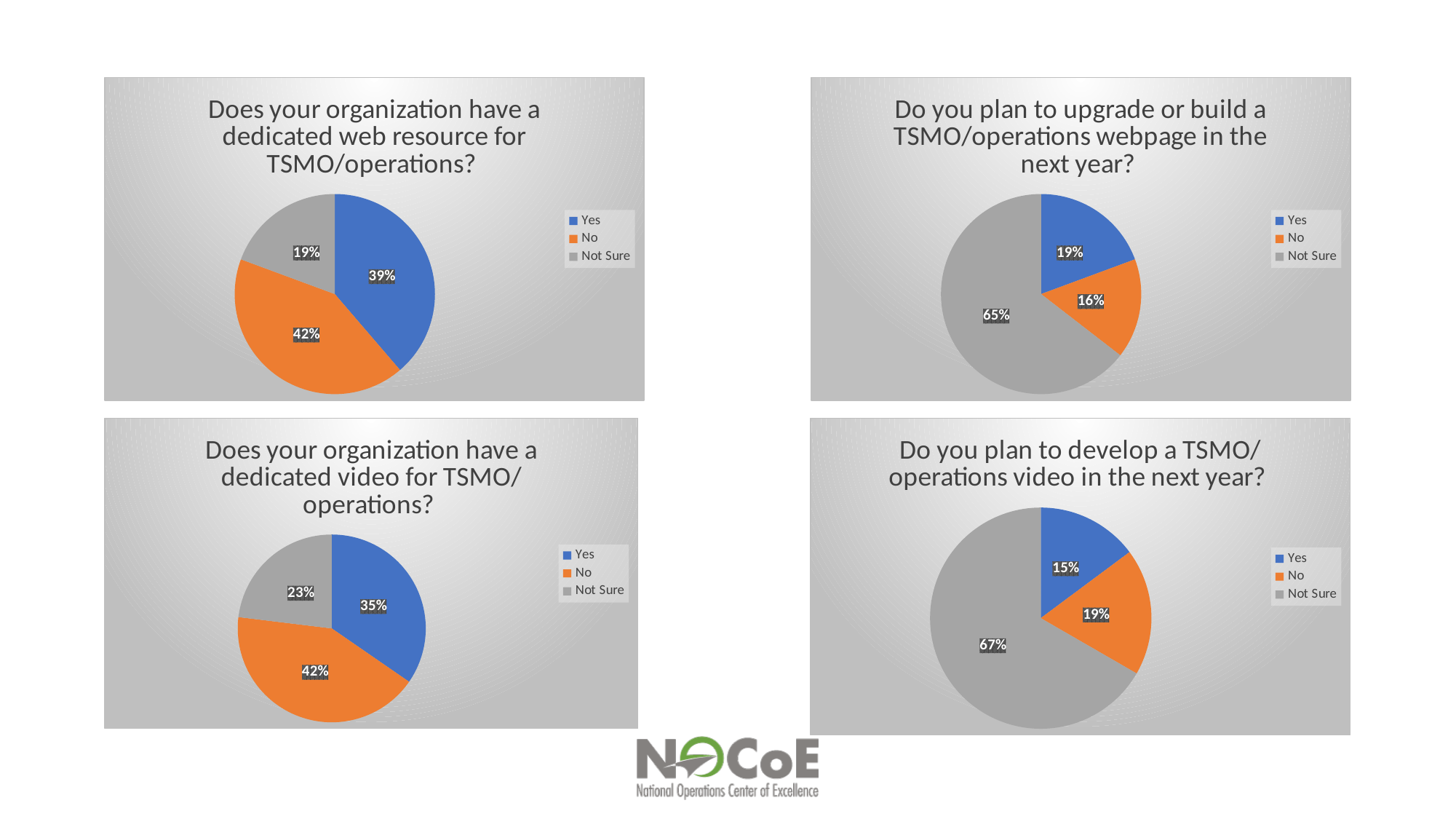
How many categories does the legend of the top-right chart 'Do you plan to upgrade or build a TSMO/operations webpage in the next year?' list? 3 In the bottom-right chart 'Do you plan to develop a TSMO/operations video in the next year?', what is the difference in percentage points between Not Sure and No? 48 In the top-right chart 'Do you plan to upgrade or build a TSMO/operations webpage in the next year?', which response has the smallest share? No In the top-left chart 'Does your organization have a dedicated web resource for TSMO/operations?', what percentage answered Yes? 39% In the bottom-left chart 'Does your organization have a dedicated video for TSMO/operations?', what colour represents the Not Sure slice? Gray In the bottom-right chart 'Do you plan to develop a TSMO/operations video in the next year?', what percentage answered Yes? 15% In the bottom-left chart 'Does your organization have a dedicated video for TSMO/operations?', what is the difference in percentage points between No and Yes? 7 In the top-left chart 'Does your organization have a dedicated web resource for TSMO/operations?', which response has the largest share? No In the top-right chart 'Do you plan to upgrade or build a TSMO/operations webpage in the next year?', what percentage answered Not Sure? 65% In the bottom-right chart 'Do you plan to develop a TSMO/operations video in the next year?', which is larger, the Yes share or the No share? No In the bottom-left chart 'Does your organization have a dedicated video for TSMO/operations?', what percentage answered Not Sure? 23% What type of chart is used in the top-left chart 'Does your organization have a dedicated web resource for TSMO/operations?'? Pie chart